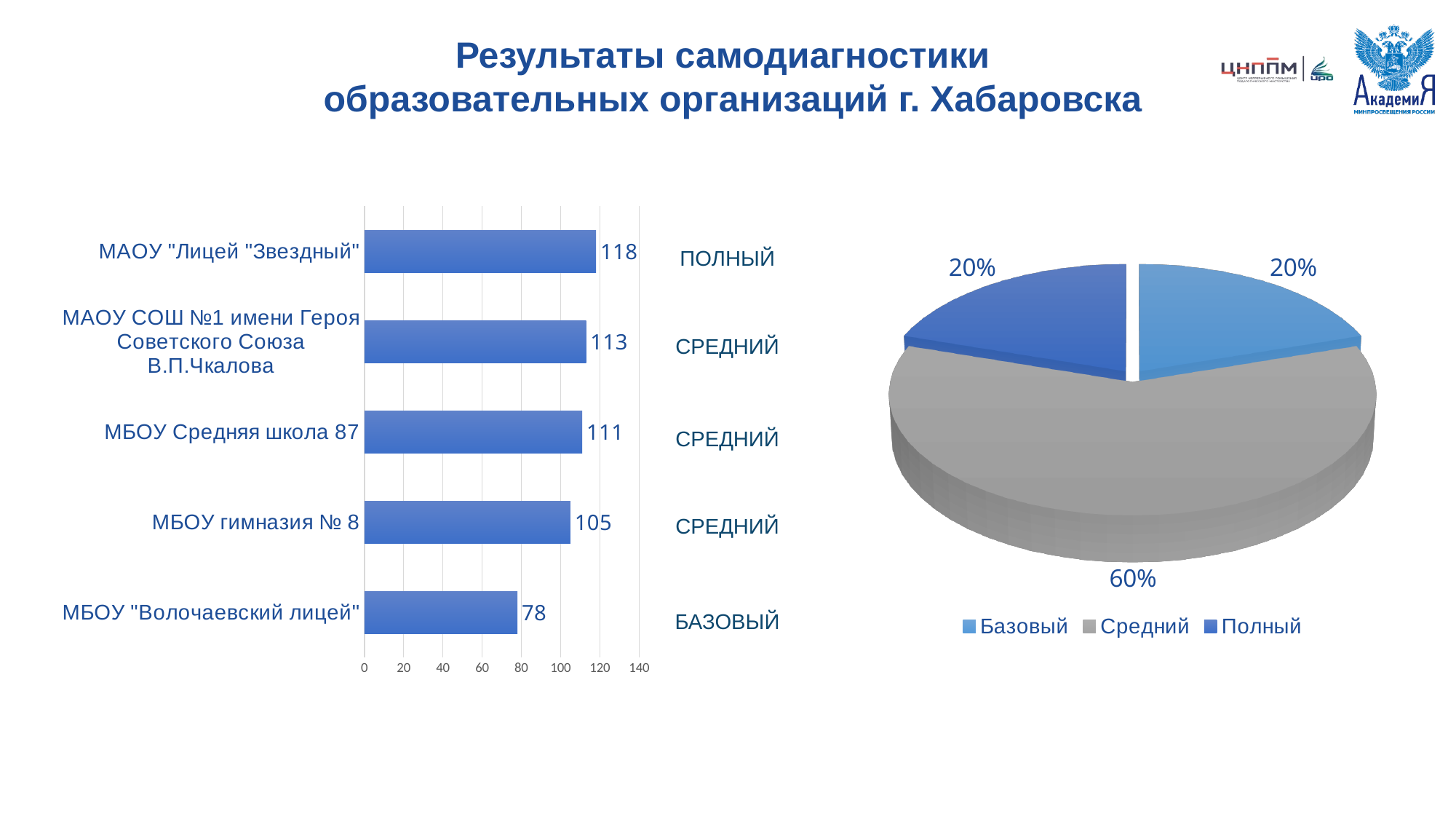
In the bar chart on the left, what is the difference between the values for МАОУ "Лицей "Звездный" and МБОУ "Волочаевский лицей"? 40 What kind of chart is on the left side of the slide? Bar chart In the pie chart on the right, what share does Базовый have? 20% In the bar chart on the left, which organisation has the lowest value? МБОУ "Волочаевский лицей" In the bar chart on the left, how many organisations are shown? 5 In the bar chart on the left, what is the value for МБОУ гимназия № 8? 105 In the pie chart on the right, what share does Средний have? 60% In the bar chart on the left, what is the value for МАОУ "Лицей "Звездный"? 118 In the bar chart on the left, which organisation has the highest value? МАОУ "Лицей "Звездный" How many entries does the legend of the pie chart on the right list? 3 In the bar chart on the left, which has a larger value: МБОУ Средняя школа 87 or МБОУ гимназия № 8? МБОУ Средняя школа 87 In the bar chart on the left, what is the value for МБОУ "Волочаевский лицей"? 78